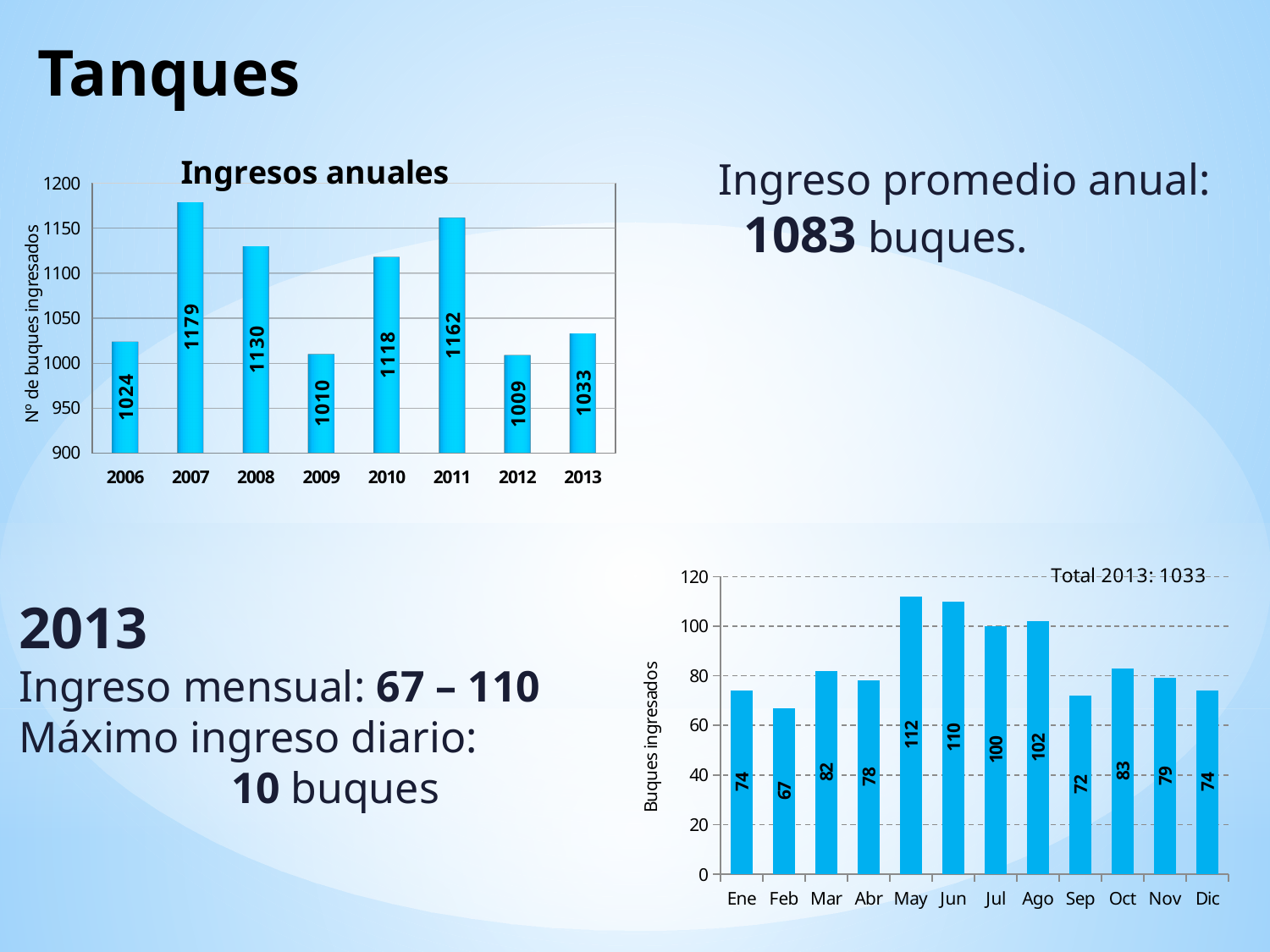
In the 'Ingresos anuales' chart, how many years are shown? 8 In the monthly chart at the bottom right, which month has the lowest value? Feb In the 'Ingresos anuales' chart, what is the value for 2007? 1179 In the 'Ingresos anuales' chart, what is the difference between the values for 2011 and 2010? 44 In the 'Ingresos anuales' chart, which is larger, the value for 2008 or the value for 2013? 2008 In the monthly chart at the bottom right, how many months are shown? 12 What kind of chart is the 'Ingresos anuales' chart? Bar chart In the monthly chart at the bottom right, what is the value for May? 112 What is the y-axis label of the monthly chart at the bottom right? Buques ingresados In the 'Ingresos anuales' chart, which year has the lowest value? 2012 In the 'Ingresos anuales' chart, which year has the highest value? 2007 In the monthly chart at the bottom right, what is the difference between the values for Oct and Sep? 11